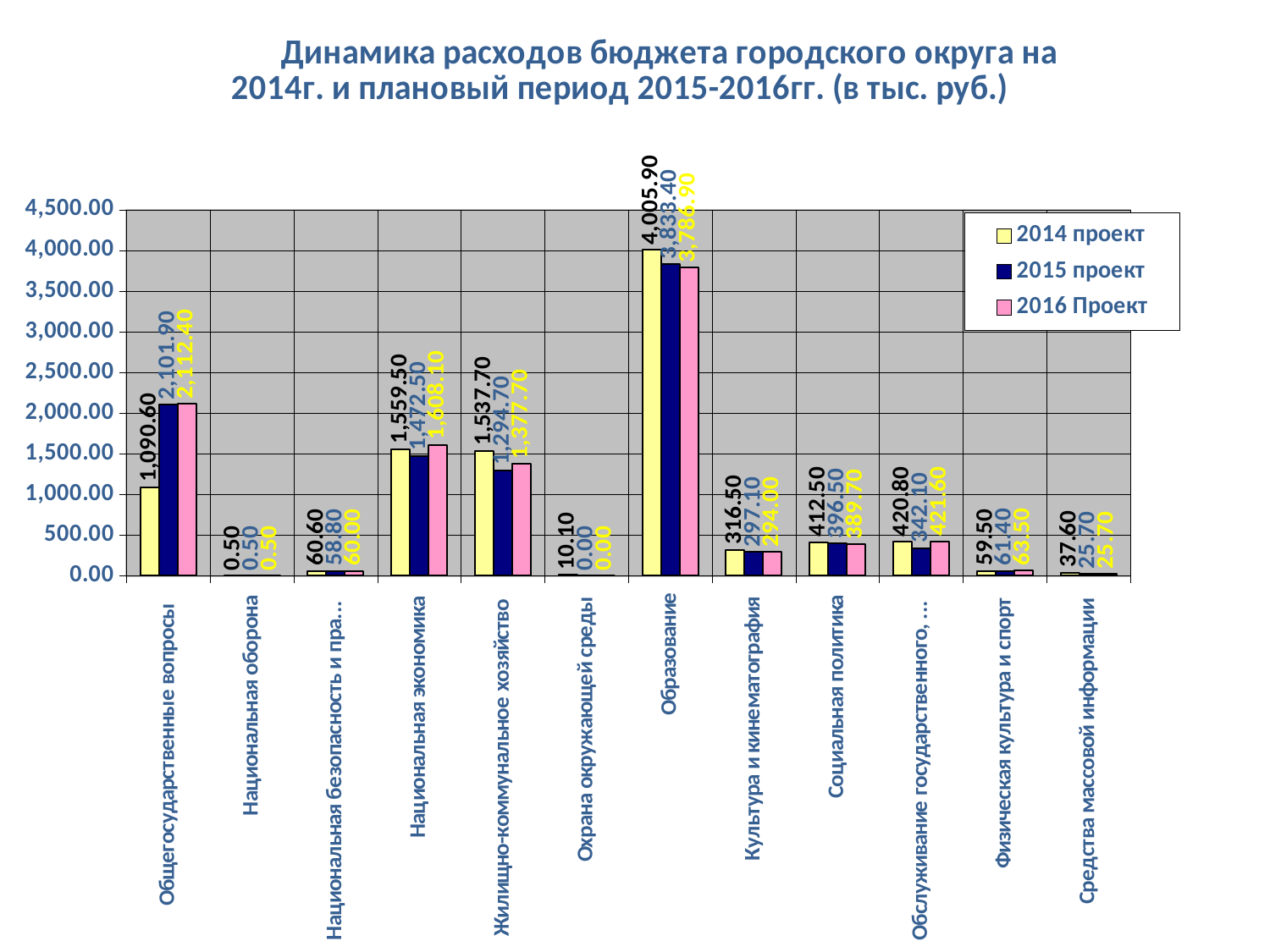
What is the 2015 проект value for Жилищно-коммунальное хозяйство? 1,294.70 Which category has the highest 2014 проект value? Образование Which category has the lowest 2015 проект value? Охрана окружающей среды How many categories are shown on the x axis? 12 What kind of chart is shown on the slide? bar chart Which colour represents the 2015 проект series? dark blue What is the difference between the 2014 проект and 2015 проект values for Образование? 172.50 Which is larger for Национальная экономика: the 2014 проект value or the 2016 Проект value? 2016 Проект What is the 2016 Проект value for Общегосударственные вопросы? 2,112.40 How many series does the legend list? 3 What is the 2014 проект value for Образование? 4,005.90 Is the 2015 проект value for Социальная политика greater or less than 500.00? less